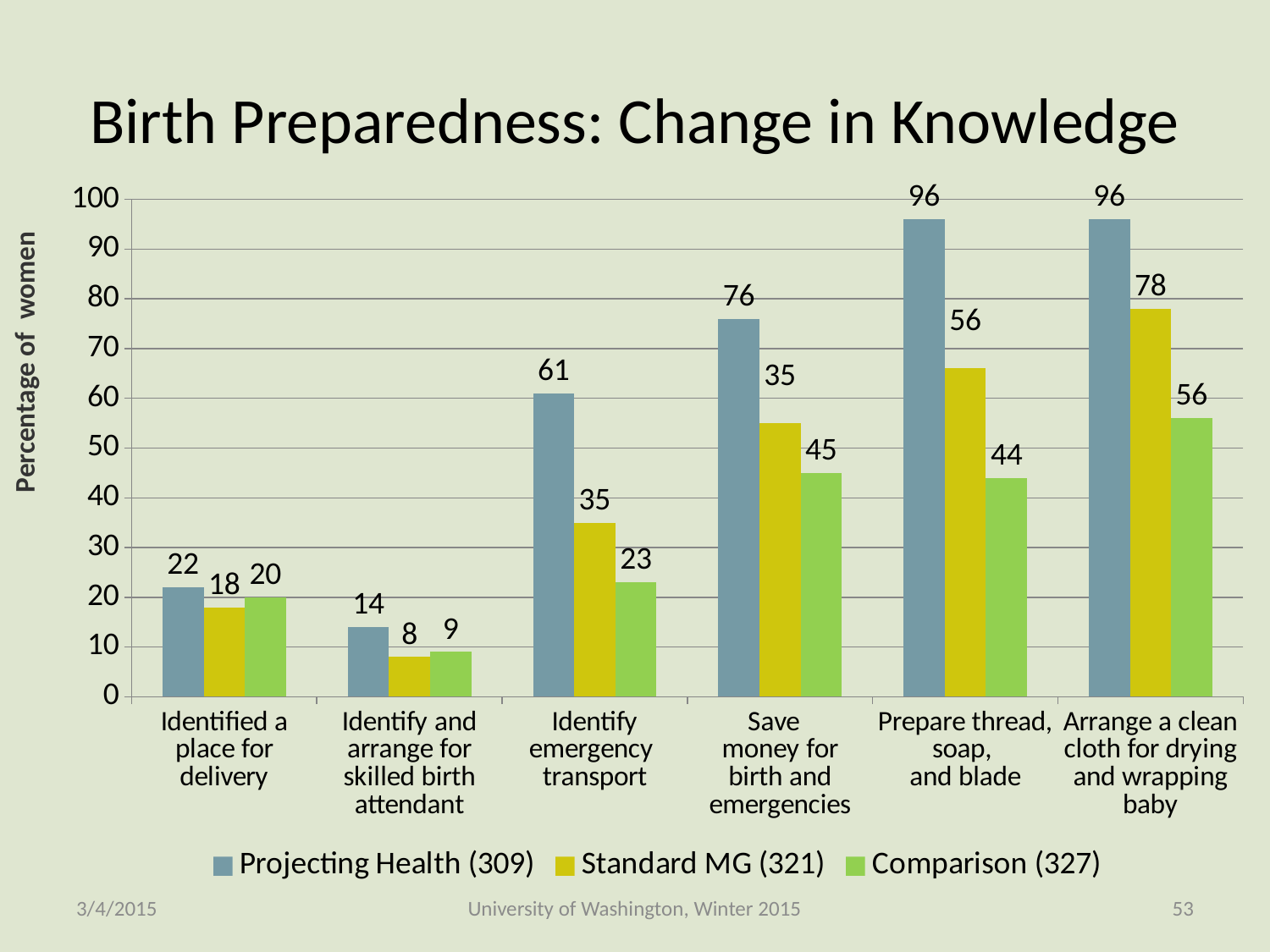
What is the label of the y axis? Percentage of women Which series has the highest value for 'Identify emergency transport'? Projecting Health (309) What kind of chart is shown on the slide? bar chart Which category has the lowest value for Projecting Health (309)? Identify and arrange for skilled birth attendant Is the value for Projecting Health (309) for 'Save money for birth and emergencies' greater or less than 70? greater What is the value for Comparison (327) for 'Arrange a clean cloth for drying and wrapping baby'? 56 What is the difference between the Projecting Health (309) and Comparison (327) values for 'Identify emergency transport'? 38 How many series does the legend list? 3 Which is larger for 'Identified a place for delivery': Standard MG (321) or Comparison (327)? Comparison (327) How many categories are shown on the x axis? 6 What is the value for Standard MG (321) for 'Identify and arrange for skilled birth attendant'? 8 What is the value for Projecting Health (309) for 'Identify emergency transport'? 61